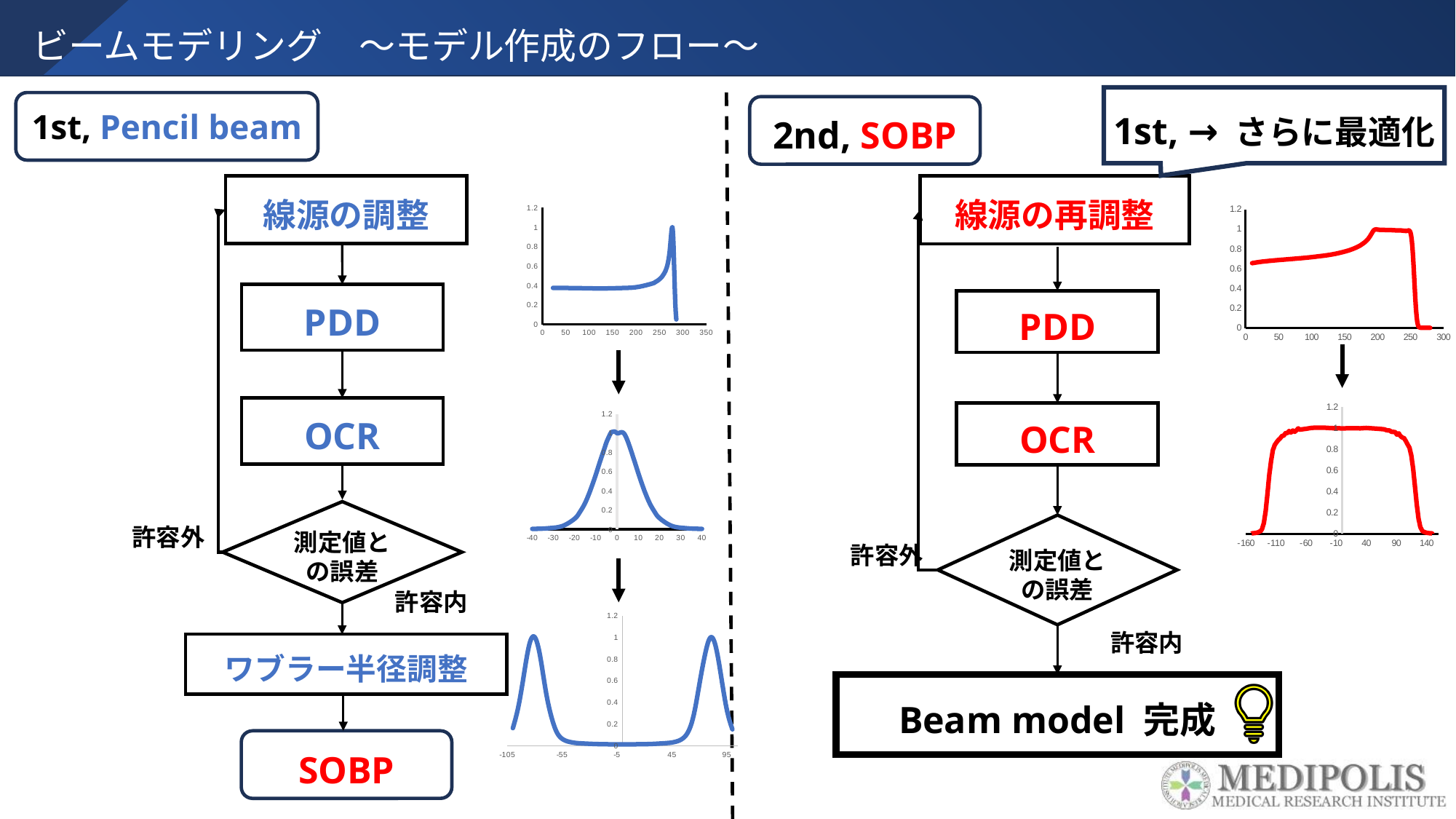
In the top-right chart (x axis 0 to 300), does the line rise or fall between x = 0 and x = 200? rise What kind of chart is the top chart on the left side of the slide (x axis 0 to 350)? line chart In the middle-left chart (x axis -40 to 40), is the value at x = 0 greater or less than 0.8? greater What colour are the lines in the two charts on the right half of the slide? red In the bottom-right chart (x axis -160 to 140), is the value at x = 40 greater or less than 0.8? greater What is the highest tick shown on the x axis of the top-left chart? 350 In the bottom-left chart (x axis -105 to 95), is the value at x = -5 greater or less than 0.2? less How many charts are shown on the slide in total? 5 What colour are the lines in the three charts on the left half of the slide? blue